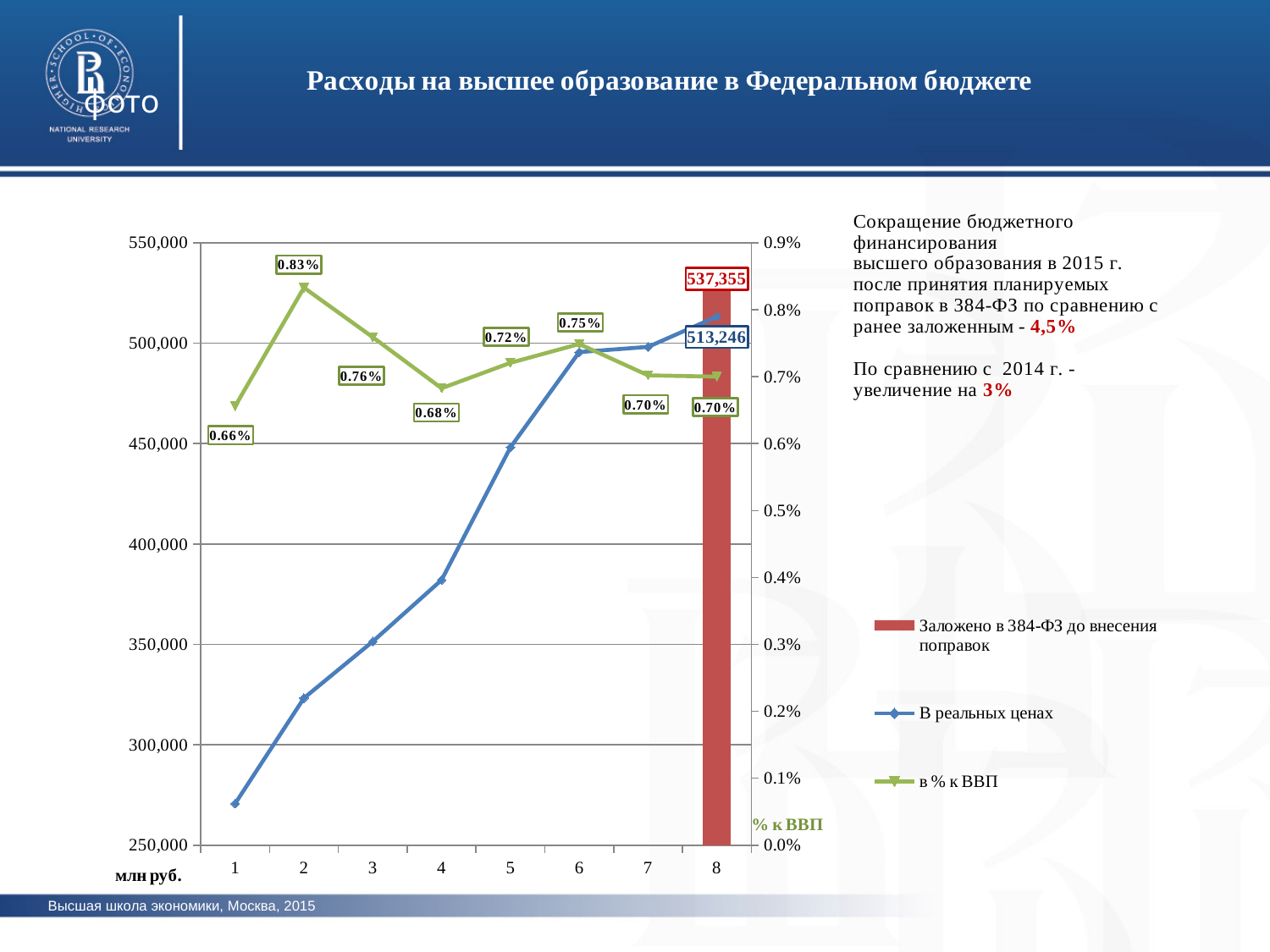
What is the value of the 'в % к ВВП' series at category 4? 0.68% At which category does the 'в % к ВВП' series have its lowest value? 1 What is the value of the 'в % к ВВП' series at category 1? 0.66% What is the value of the 'в % к ВВП' series at category 2? 0.83% Is the value of the 'В реальных ценах' line at category 1 greater or less than 300,000? less How many series does the legend list? 3 What value is labelled on the red bar 'Заложено в 384-ФЗ до внесения поправок' at category 8? 537,355 How many categories are shown on the x axis? 8 What is the difference between the highest and lowest labelled values of the 'в % к ВВП' series? 0.17% What value is labelled on the 'В реальных ценах' line at category 8? 513,246 At category 8, which is larger: the red bar value or the 'В реальных ценах' line value? The red bar (537,355) At which category does the 'в % к ВВП' series reach its highest value? 2